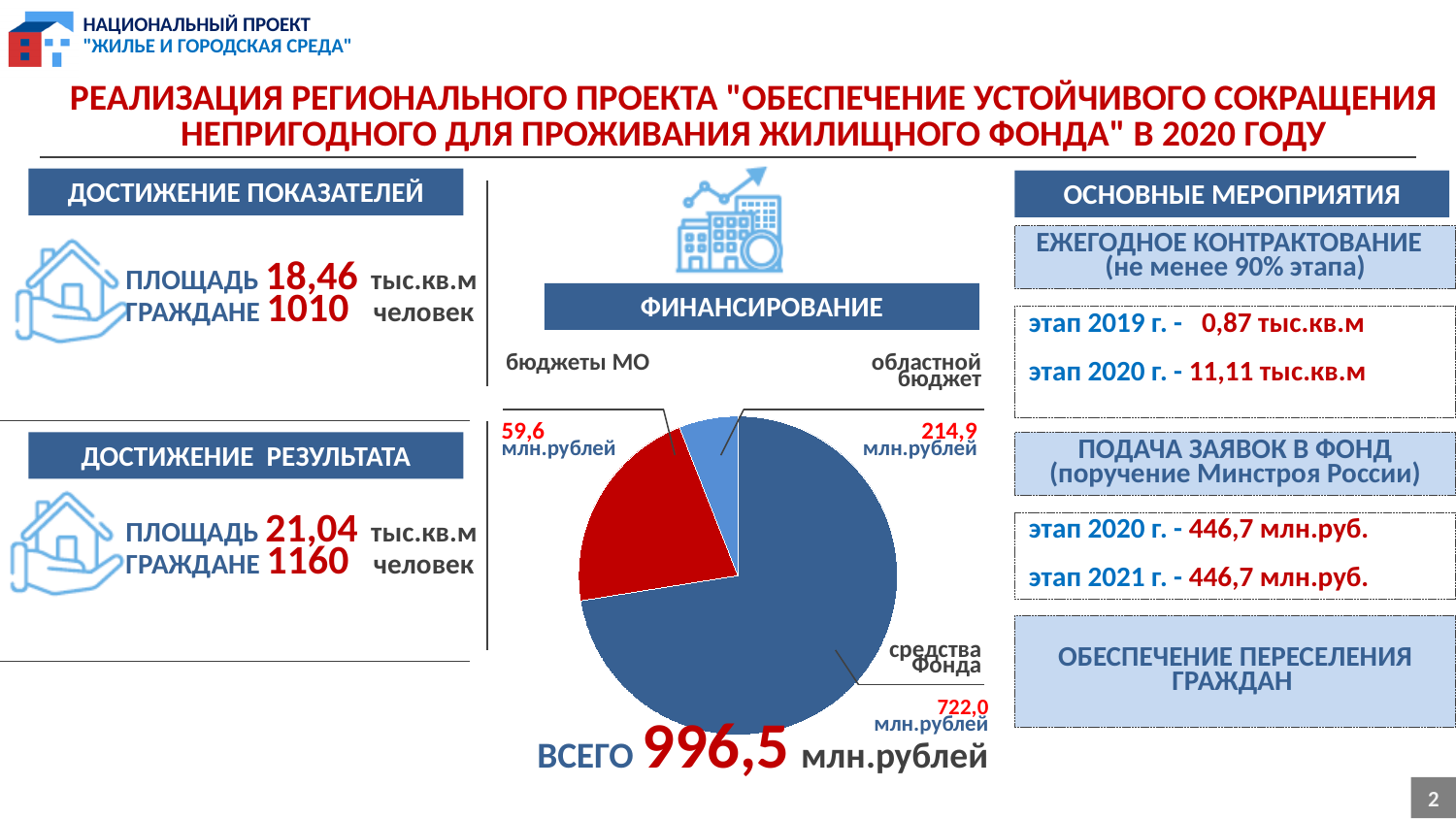
In the "ФИНАНСИРОВАНИЕ" pie chart, what is the value for "бюджеты МО"? 59,6 млн.рублей In the "ФИНАНСИРОВАНИЕ" pie chart, which source has the largest value? средства Фонда What is the total amount shown for the "ФИНАНСИРОВАНИЕ" pie chart? 996,5 млн.рублей What kind of chart is shown under the heading "ФИНАНСИРОВАНИЕ"? pie chart In the "ФИНАНСИРОВАНИЕ" pie chart, what is the value for "областной бюджет"? 214,9 млн.рублей In the "ФИНАНСИРОВАНИЕ" pie chart, which source has the smallest value? бюджеты МО In the "ФИНАНСИРОВАНИЕ" pie chart, which is larger: "областной бюджет" or "бюджеты МО"? областной бюджет In the "ФИНАНСИРОВАНИЕ" pie chart, what is the difference between "средства Фонда" and "областной бюджет"? 507,1 млн.рублей How many slices does the "ФИНАНСИРОВАНИЕ" pie chart have? 3 In the "ФИНАНСИРОВАНИЕ" pie chart, what is the value for "средства Фонда"? 722,0 млн.рублей In the "ФИНАНСИРОВАНИЕ" pie chart, what colour is the "областной бюджет" slice? red In the "ФИНАНСИРОВАНИЕ" pie chart, what is the difference between "областной бюджет" and "бюджеты МО"? 155,3 млн.рублей